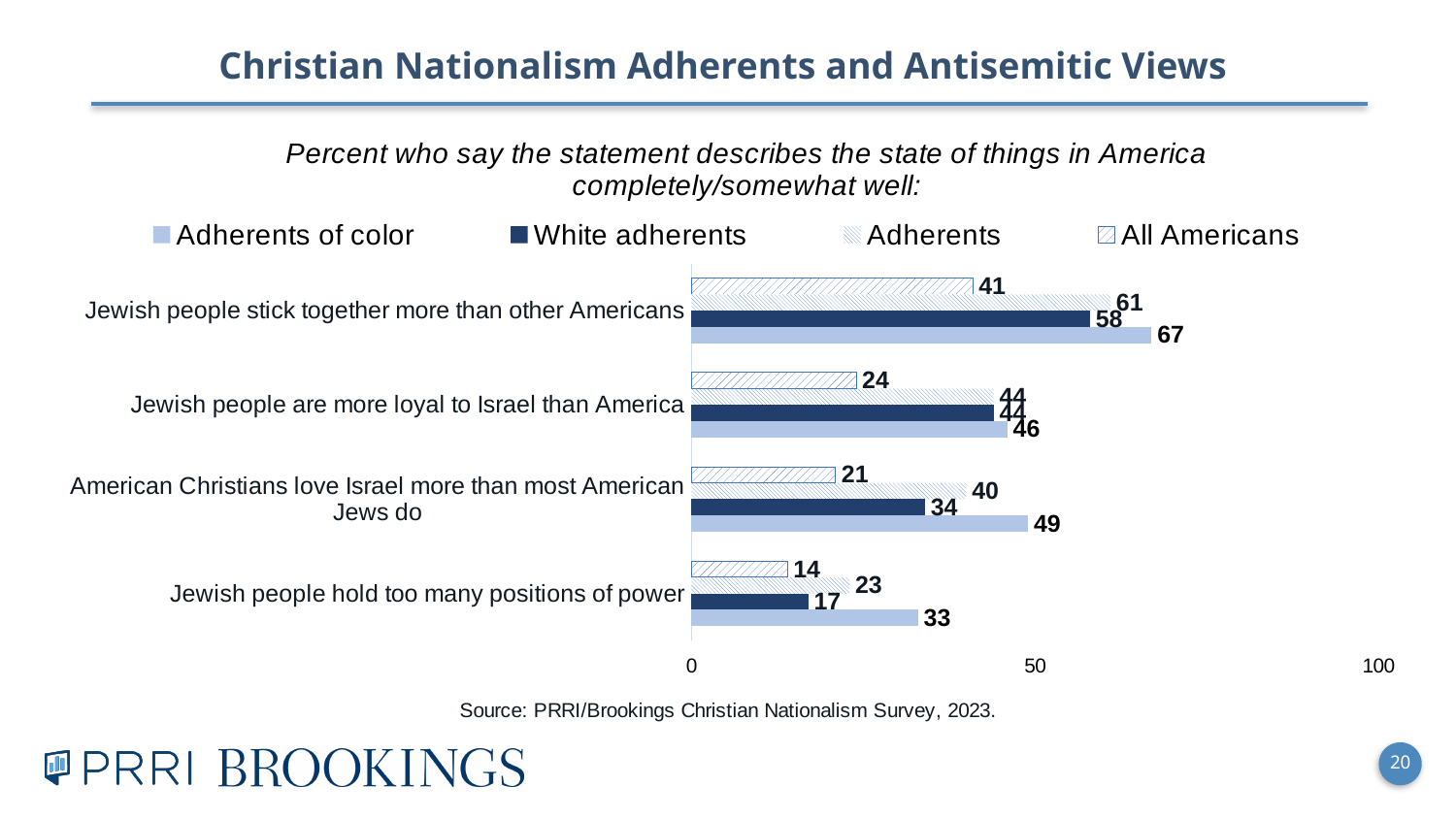
What is the value for Adherents on the statement "Jewish people are more loyal to Israel than America"? 44 What kind of chart is shown on the slide? Bar chart Which statement has the lowest value for All Americans? Jewish people hold too many positions of power For the statement "Jewish people stick together more than other Americans", which is larger: the value for Adherents or the value for White adherents? Adherents What percent of Adherents of color say "Jewish people stick together more than other Americans" describes the state of things in America well? 67 What is the value for White adherents on the statement "American Christians love Israel more than most American Jews do"? 34 What is the value for All Americans on the statement "Jewish people hold too many positions of power"? 14 How many series does the legend list? 4 What is the source cited below the chart? PRRI/Brookings Christian Nationalism Survey, 2023 What is the difference between Adherents of color and All Americans on the statement "Jewish people hold too many positions of power"? 19 How many statements (categories) are shown on the chart? 4 Which statement has the highest value for Adherents of color? Jewish people stick together more than other Americans